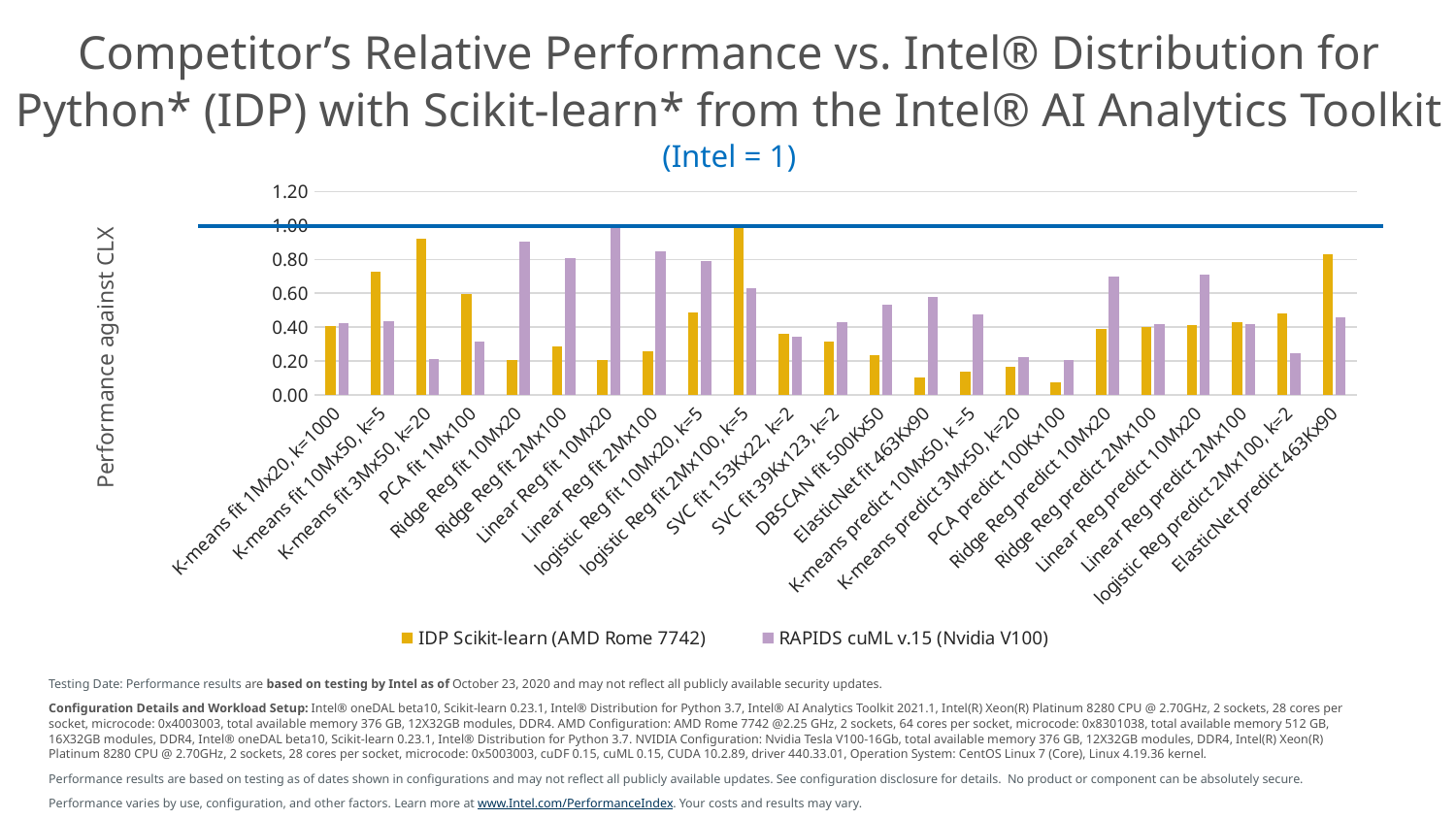
How many series does the chart legend list? 2 Which two series are listed in the legend? IDP Scikit-learn (AMD Rome 7742) and RAPIDS cuML v.15 (Nvidia V100) For ElasticNet predict 463Kx90, which series has the larger value, IDP Scikit-learn (AMD Rome 7742) or RAPIDS cuML v.15 (Nvidia V100)? IDP Scikit-learn (AMD Rome 7742) What is the label on the vertical axis? Performance against CLX Is the RAPIDS cuML v.15 (Nvidia V100) value for Linear Reg fit 10Mx20 greater or less than 0.80? greater Is the IDP Scikit-learn (AMD Rome 7742) value for K-means fit 3Mx50, k=20 greater or less than 0.80? greater How many workload categories are plotted along the x axis? 23 Is the RAPIDS cuML v.15 (Nvidia V100) value for K-means fit 3Mx50, k=20 greater or less than 0.40? less Which category has the highest RAPIDS cuML v.15 (Nvidia V100) value? Linear Reg fit 10Mx20 For Ridge Reg fit 10Mx20, which series has the larger value, IDP Scikit-learn (AMD Rome 7742) or RAPIDS cuML v.15 (Nvidia V100)? RAPIDS cuML v.15 (Nvidia V100) What kind of chart is shown on the slide? bar chart